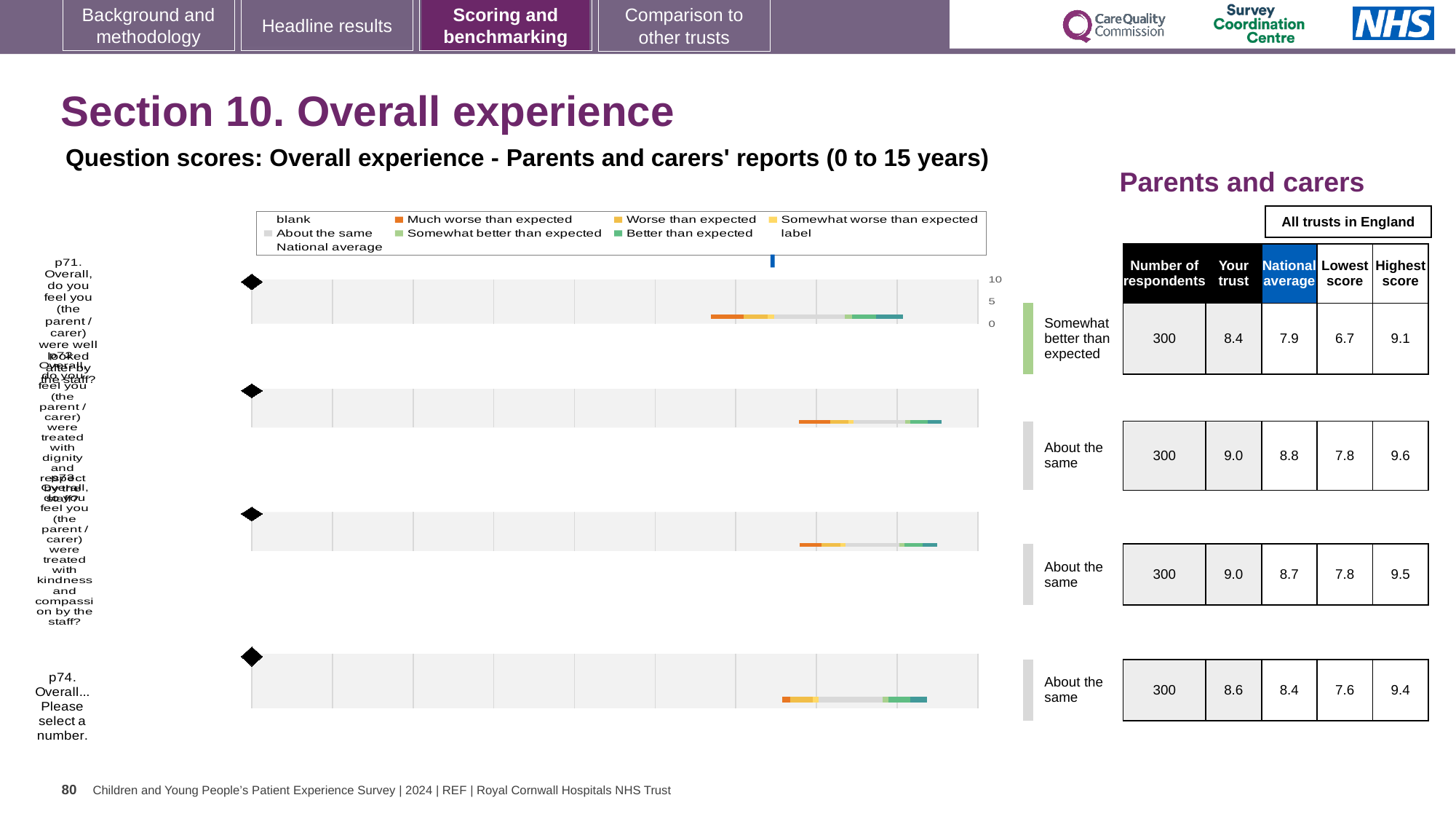
In the table beside the chart, what is the national average for the top row (p71)? 7.9 In the chart legend, what colour represents 'Much worse than expected'? orange How many question rows (bars) does the chart contain? 4 What is the largest value in the 'Highest score' column of the table beside the chart? 9.6 For the top row (p71), what is the difference between the 'Your trust' score and the national average? 0.5 What is the smallest value in the 'Lowest score' column of the table beside the chart? 6.7 For the top row (p71), which is larger: the 'Your trust' score or the national average? Your trust What kind of chart is shown on the slide? bar chart What benchmark label is given for the top row (p71) of the chart? Somewhat better than expected In the table beside the chart, what is the number of respondents for the top row (p71)? 300 In the chart legend, what colour represents 'Better than expected'? green In the table beside the chart, what is the 'Your trust' score for the top row (p71)? 8.4